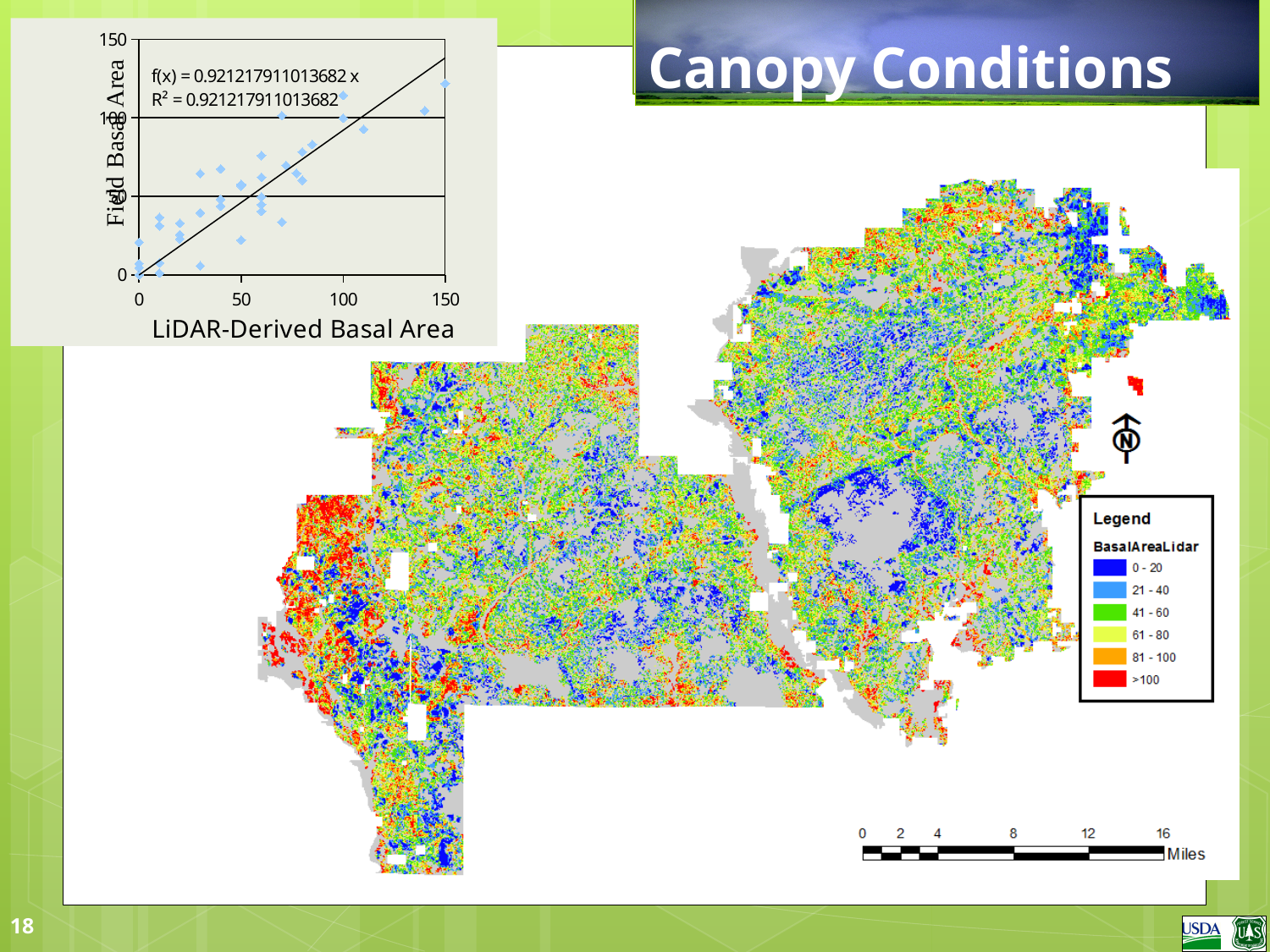
In the scatter chart, do the Field Basal Area values generally rise or fall as LiDAR-Derived Basal Area increases? rise In the scatter chart, what is the title of the y axis? Field Basal Area In the scatter chart, what is the title of the x axis? LiDAR-Derived Basal Area In the scatter chart, how many tick labels are shown on the x axis? 4 What kind of chart is shown in the top-left of the slide? scatter chart In the scatter chart, is the Field Basal Area for the point with the largest LiDAR-Derived Basal Area greater or less than 50? greater In the scatter chart, what is the trendline equation printed on the chart? f(x) = 0.921217911013682 x In the scatter chart, is the slope of the trendline greater or less than 1? less In the scatter chart, what R² value is printed on the chart? 0.921217911013682 In the scatter chart, what is the highest tick value shown on the y axis? 150